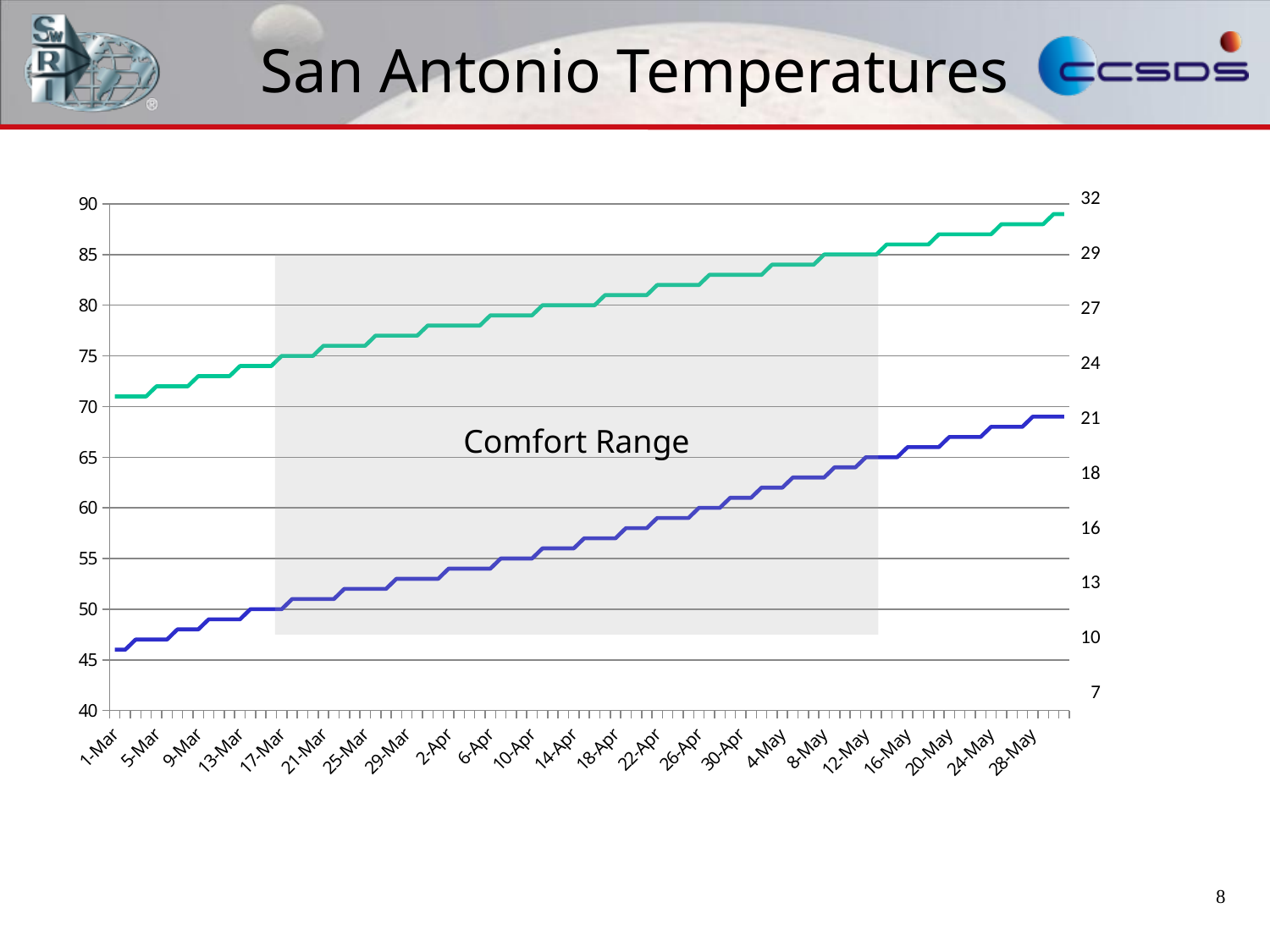
Do the values of the green line rise or fall from 1-Mar to 28-May? rise How many lines are plotted on the chart? 2 What kind of chart is shown on the slide? line chart Do the values of the blue line rise or fall from 1-Mar to 28-May? rise What label appears inside the shaded grey box on the chart? Comfort Range Is the value of the blue line on 28-May greater or less than 65 on the left axis? greater Is the value of the green line on 28-May greater or less than 85 on the left axis? greater Is the value of the blue line on 1-Mar greater or less than 50 on the left axis? less Which line has the higher value on 1-Mar, the green line or the blue line? green line